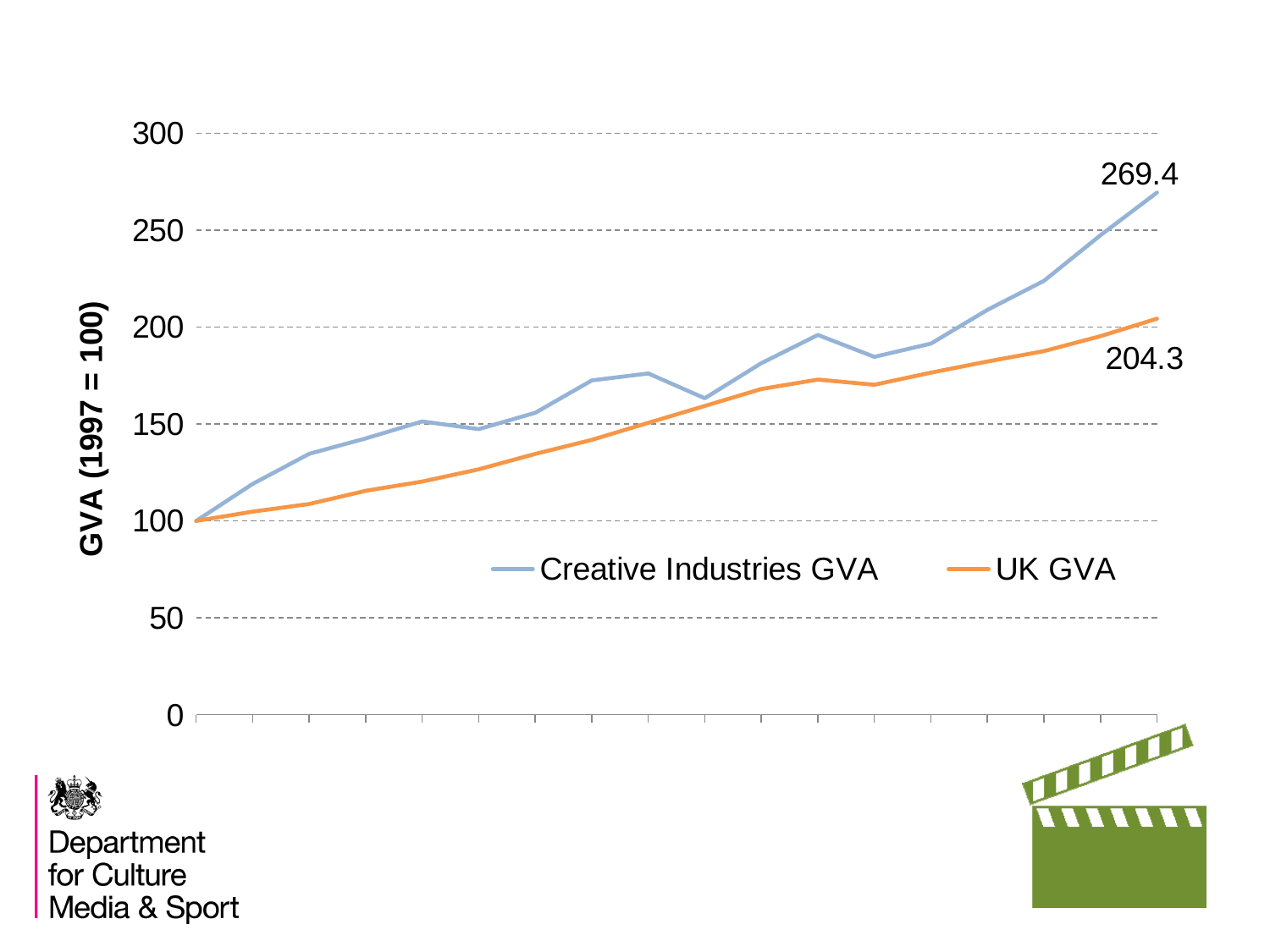
What is the final labelled value of the Creative Industries GVA series? 269.4 Does the Creative Industries GVA series rise or fall overall along the x axis? rise What kind of chart is shown on the slide? line chart Which series reaches the highest value on the chart? Creative Industries GVA Is the highest value of the UK GVA series greater or less than 250? less What is the final labelled value of the UK GVA series? 204.3 How many series does the legend list? 2 Which series ends at a higher value, Creative Industries GVA or UK GVA? Creative Industries GVA What colour is the UK GVA line? orange What is the title of the y axis? GVA (1997 = 100) What is the difference between the final values of Creative Industries GVA and UK GVA? 65.1 Does the UK GVA series rise or fall along the x axis? rise